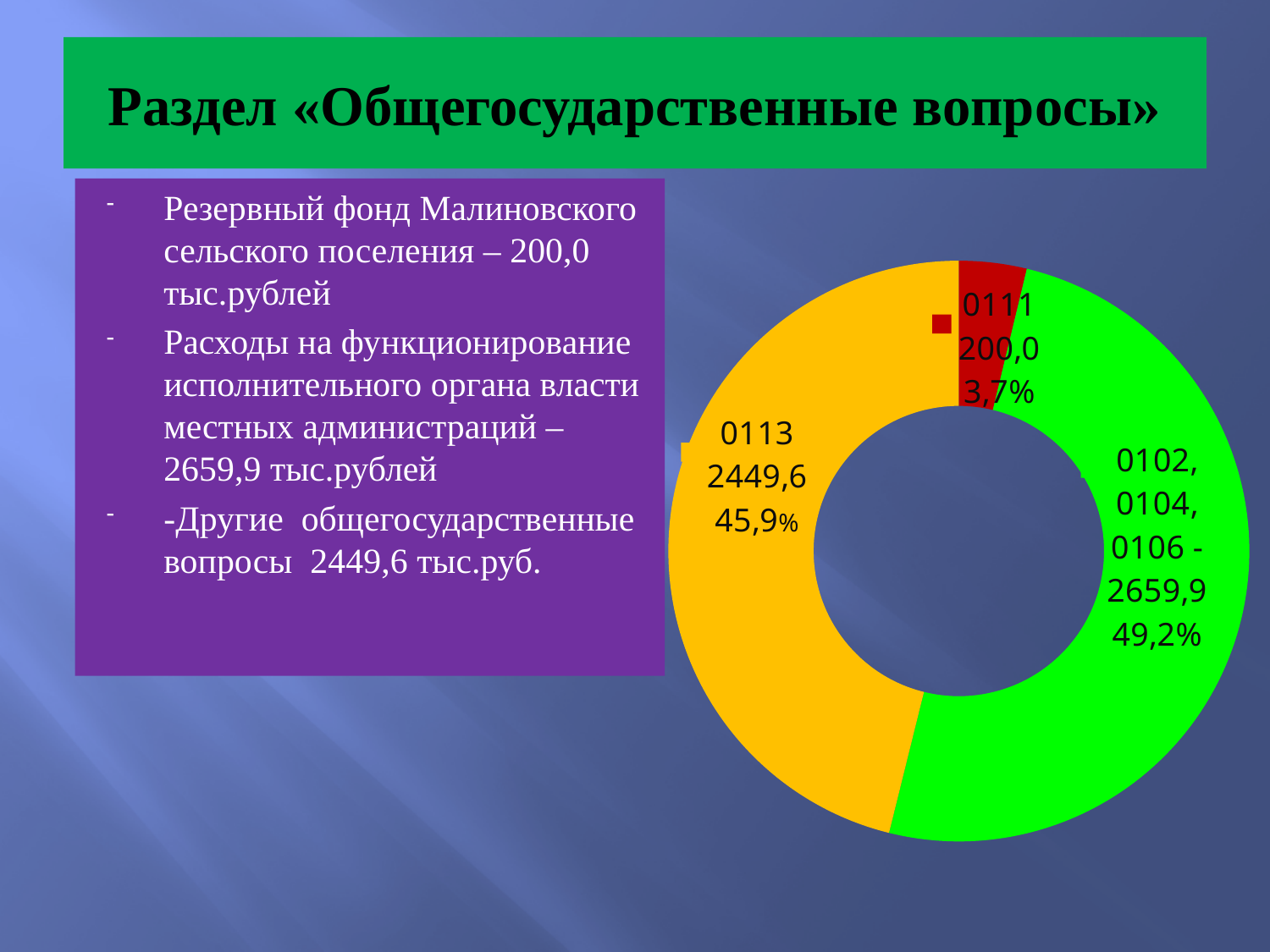
What is the value shown for slice 0111? 200,0 What percentage share is shown for slice 0113? 45,9% What is the difference between the values of slice 0102, 0104, 0106 and slice 0113? 210,3 Which slice has the smallest value? 0111 What is the value shown for the slice labelled 0102, 0104, 0106? 2659,9 What kind of chart is shown on the slide? doughnut chart What percentage share is shown for slice 0111? 3,7% How many slices does the doughnut chart have? 3 What is the value shown for slice 0113? 2449,6 Which slice has the largest value? 0102, 0104, 0106 What percentage share is shown for the slice labelled 0102, 0104, 0106? 49,2% What colour is the slice for 0111? red